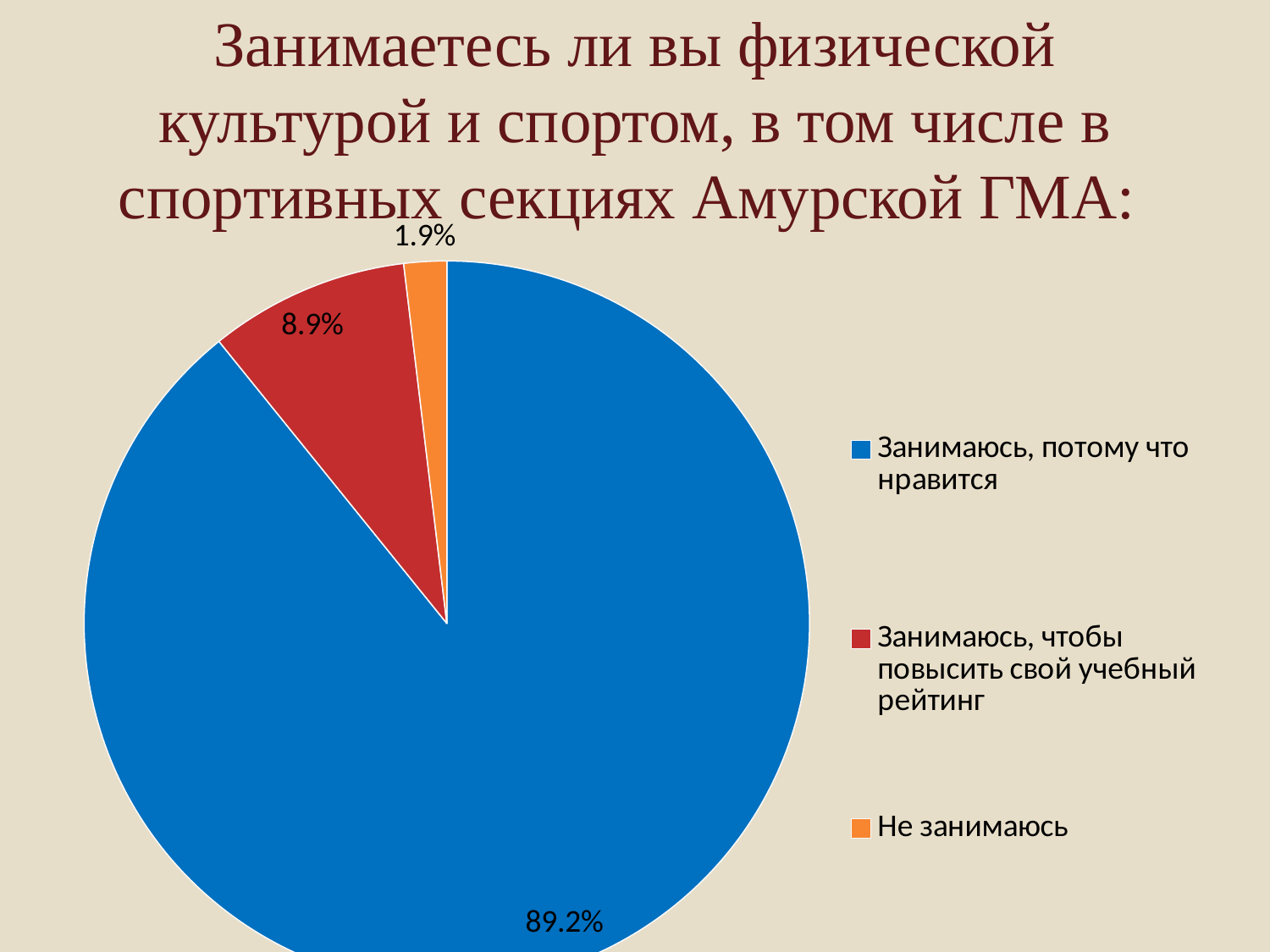
What colour is the slice for "Не занимаюсь"? orange How many slices does the pie chart have? 3 Which is larger: the share for "Занимаюсь, чтобы повысить свой учебный рейтинг" or the share for "Не занимаюсь"? Занимаюсь, чтобы повысить свой учебный рейтинг What type of chart is shown on the slide? pie chart What percentage of respondents answered "Не занимаюсь"? 1.9% What percentage of respondents answered "Занимаюсь, потому что нравится"? 89.2% How many entries does the legend list? 3 Which response has the smallest share of the pie? Не занимаюсь What percentage of respondents answered "Занимаюсь, чтобы повысить свой учебный рейтинг"? 8.9% Which response has the largest share of the pie? Занимаюсь, потому что нравится What is the difference in percentage points between "Занимаюсь, чтобы повысить свой учебный рейтинг" and "Не занимаюсь"? 7.0 What is the difference in percentage points between "Занимаюсь, потому что нравится" and "Занимаюсь, чтобы повысить свой учебный рейтинг"? 80.3